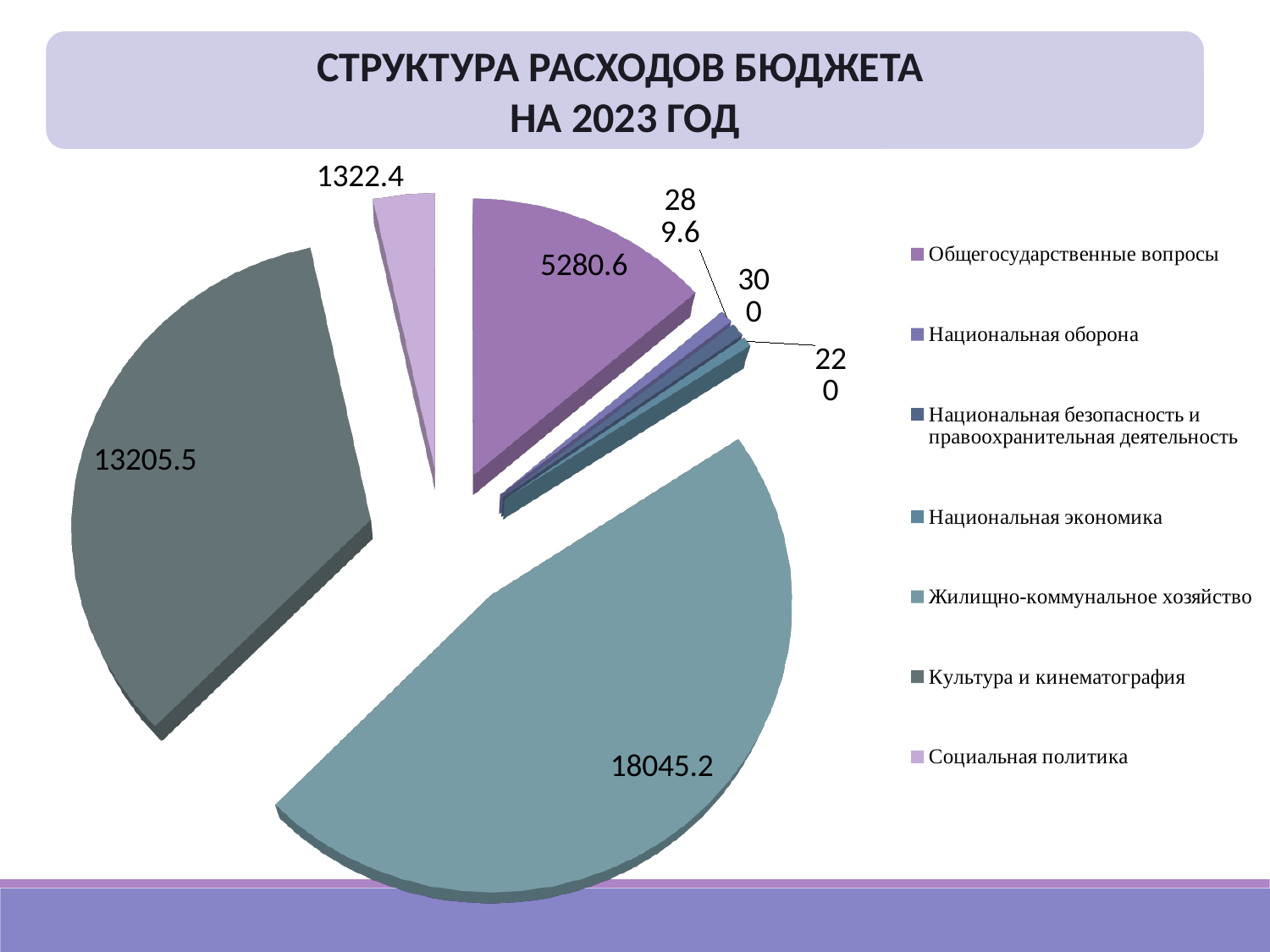
What is the value for Культура и кинематография? 13205.5 How many categories does the legend list? 7 What is the difference between the values for Общегосударственные вопросы and Социальная политика? 3958.2 What is the value for Жилищно-коммунальное хозяйство? 18045.2 Which category has the largest slice of the pie? Жилищно-коммунальное хозяйство Which is larger: the value for Культура и кинематография or the value for Общегосударственные вопросы? Культура и кинематография What type of chart is shown on the slide? Pie chart What is the difference between the values for Жилищно-коммунальное хозяйство and Культура и кинематография? 4839.7 What is the title of the chart? СТРУКТУРА РАСХОДОВ БЮДЖЕТА НА 2023 ГОД What is the value for Социальная политика? 1322.4 Which category has the smallest slice of the pie? Национальная экономика What is the value for Общегосударственные вопросы? 5280.6